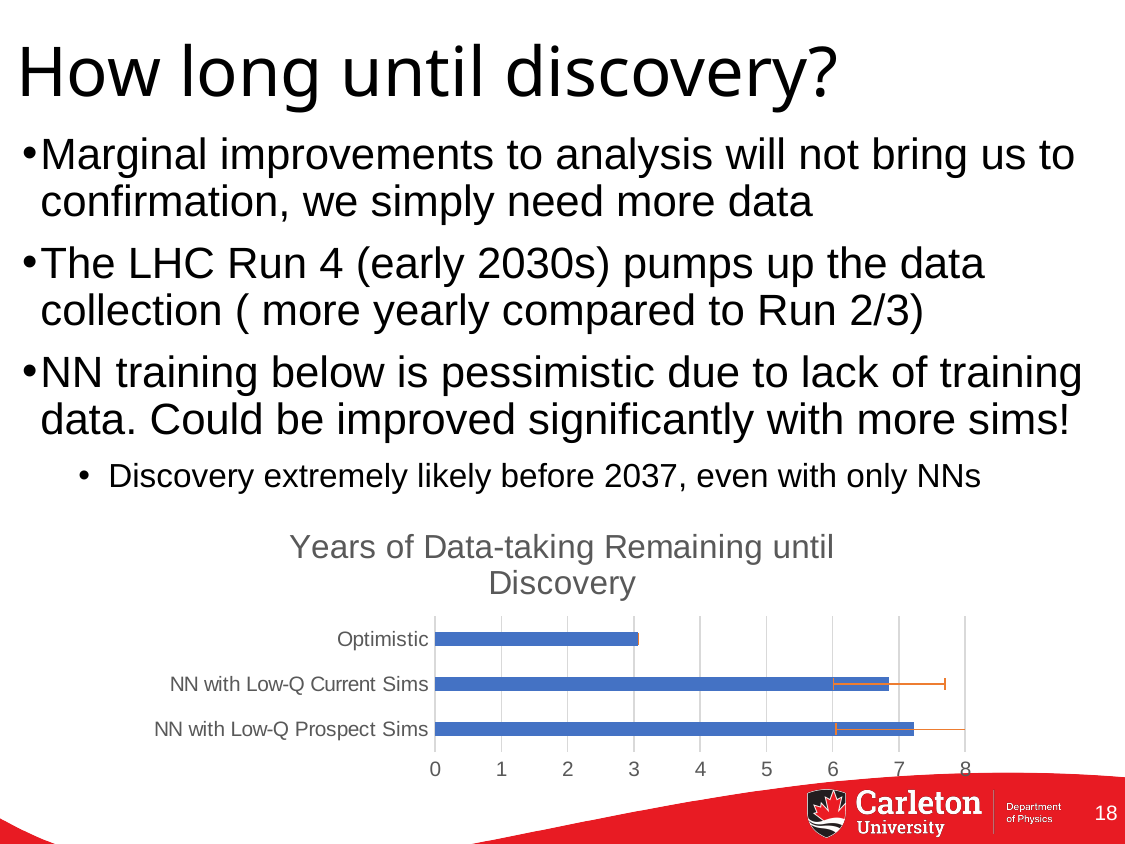
Which category has the highest value in the chart? NN with Low-Q Prospect Sims Is the value for NN with Low-Q Prospect Sims greater or less than 5? greater Is the value for NN with Low-Q Prospect Sims greater or less than 8? less Is the value for NN with Low-Q Current Sims greater or less than 6? greater Which category has the lowest value in the chart? Optimistic Which is larger, the value for Optimistic or the value for NN with Low-Q Current Sims? NN with Low-Q Current Sims What is the title of the chart? Years of Data-taking Remaining until Discovery What is the maximum value shown on the horizontal axis of the chart? 8 How many categories are plotted in the chart? 3 What kind of chart is shown on the slide? bar chart